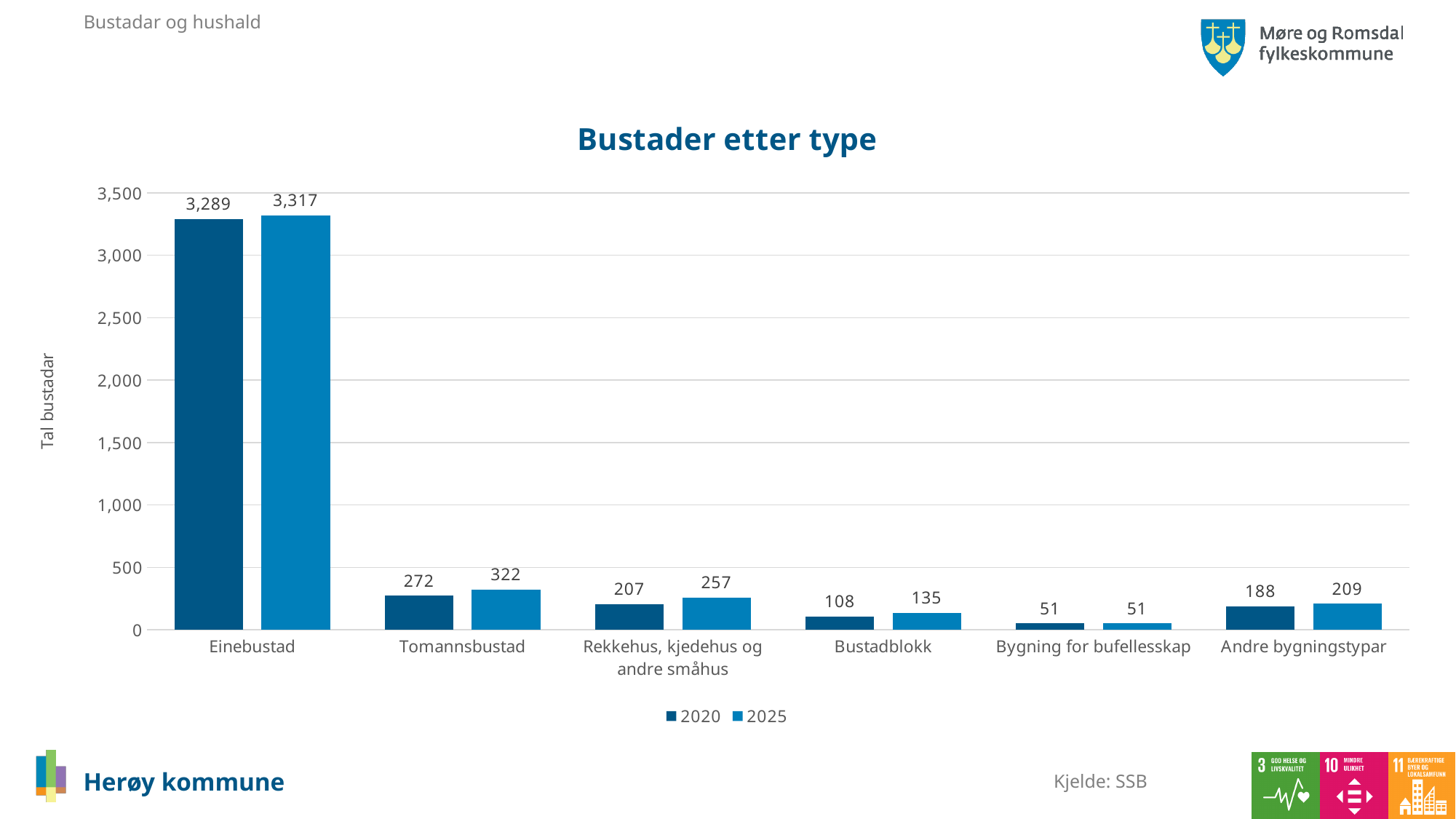
Which category has the highest value in 2020? Einebustad What is the value for Einebustad in 2025? 3,317 How many categories are shown on the x axis? 6 Which is larger: the 2020 value for Andre bygningstypar or the 2020 value for Bustadblokk? Andre bygningstypar What is the label on the y axis? Tal bustadar How many series does the legend list? 2 What is the difference between the 2025 and 2020 values for Rekkehus, kjedehus og andre småhus? 50 What kind of chart is shown? Bar chart What is the value for Bustadblokk in 2025? 135 What is the value for Tomannsbustad in 2020? 272 What is the title of the chart? Bustader etter type Which category has the lowest value in 2025? Bygning for bufellesskap